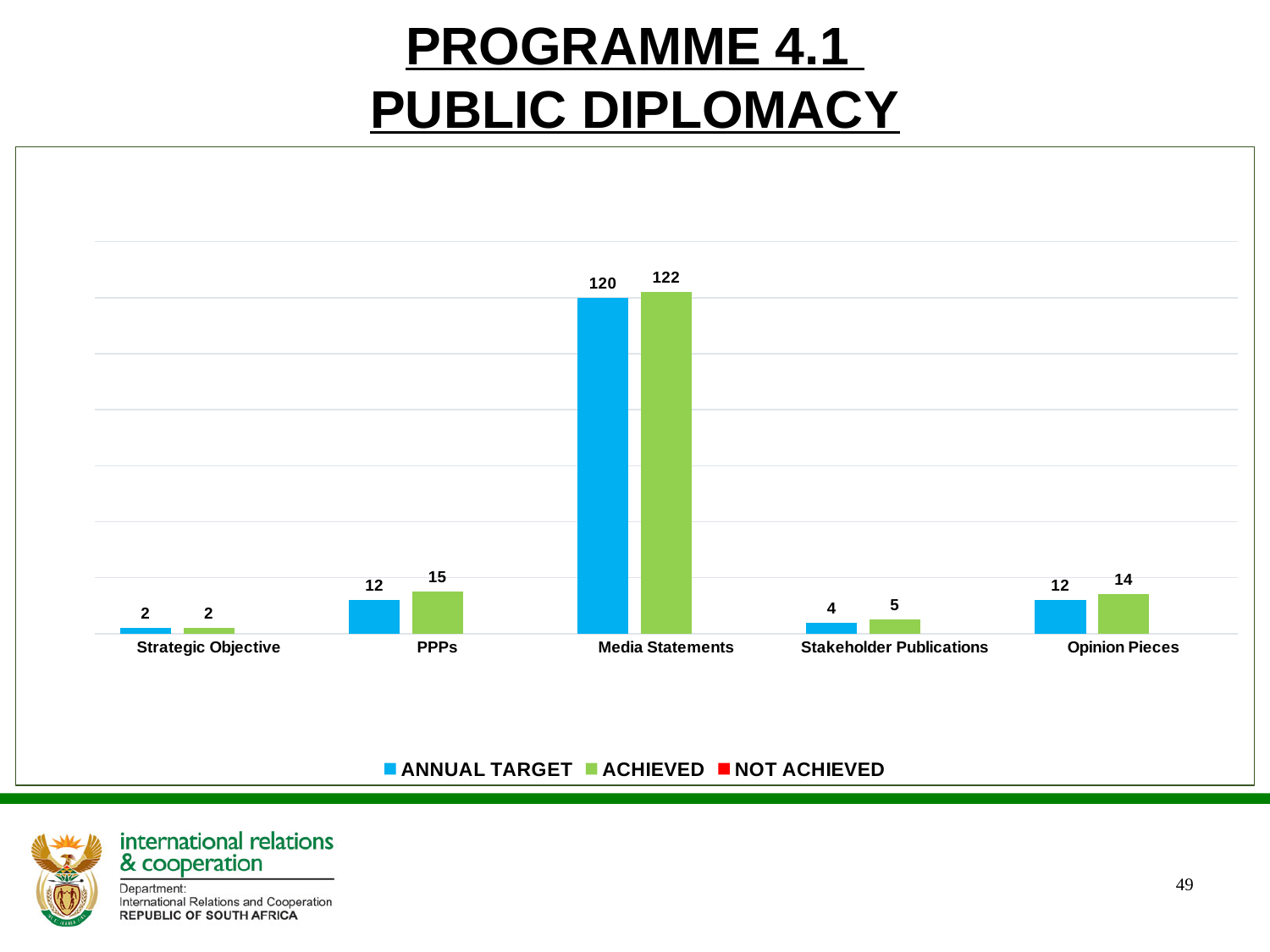
What is the difference between the ACHIEVED and ANNUAL TARGET values for PPPs? 3 What is the ANNUAL TARGET value for Media Statements? 120 What kind of chart is shown on the slide? Bar chart What is the ACHIEVED value for Stakeholder Publications? 5 Which category has the lowest ANNUAL TARGET value? Strategic Objective How many series does the legend list? 3 What is the ANNUAL TARGET value for Opinion Pieces? 12 Which category has the highest ACHIEVED value? Media Statements What is the difference between the ACHIEVED and ANNUAL TARGET values for Media Statements? 2 What is the ACHIEVED value for PPPs? 15 How many categories are shown on the x axis? 5 Which is larger for Opinion Pieces, the ANNUAL TARGET or the ACHIEVED value? ACHIEVED